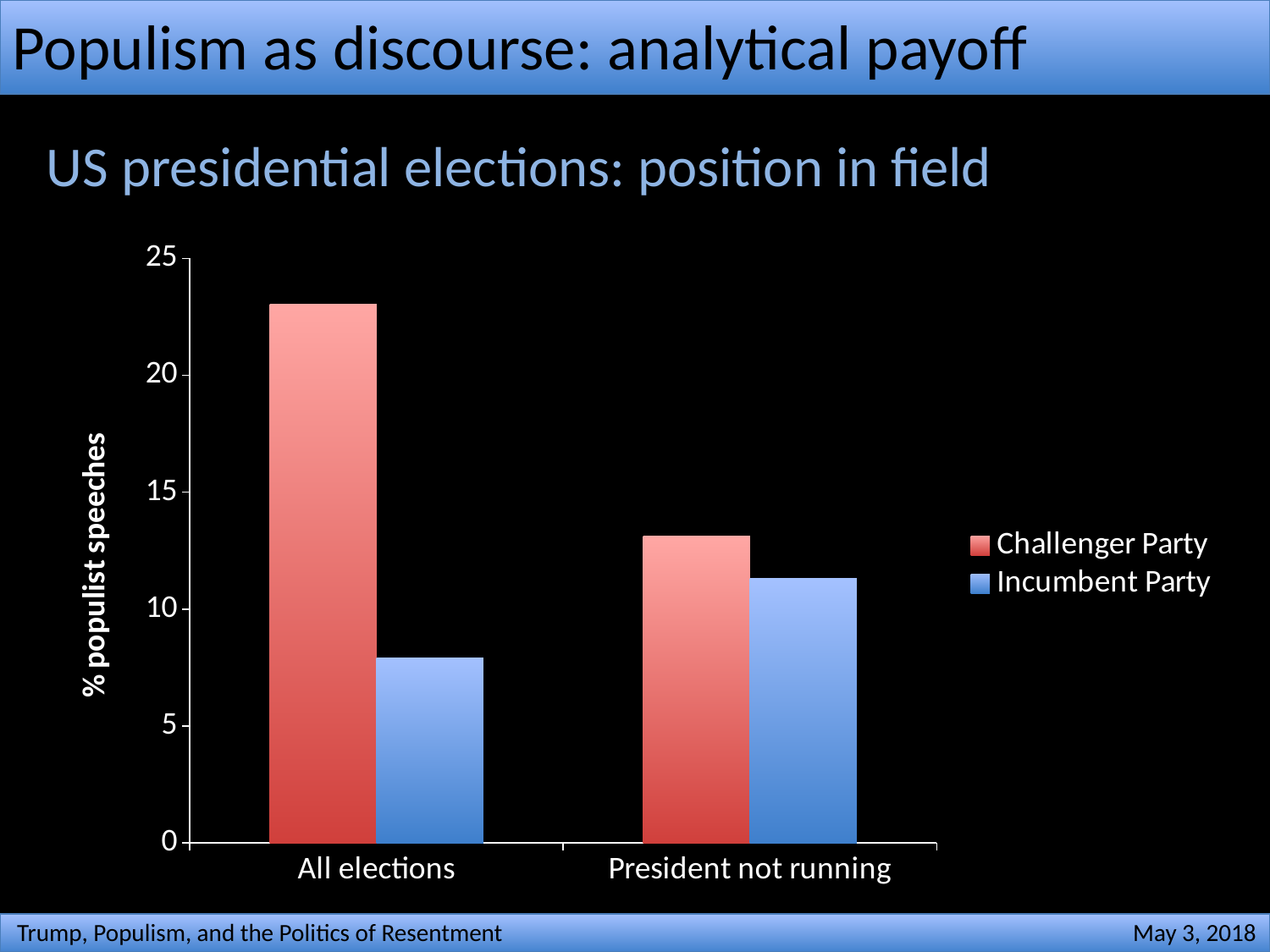
Is the value for Incumbent Party in All elections greater or less than 10? less Is the value for Incumbent Party in President not running greater or less than 15? less Is the value for Challenger Party in President not running greater or less than 15? less Which bar on the chart is the lowest? Incumbent Party in All elections How many series does the legend list? 2 For the Incumbent Party, which category has the larger value, All elections or President not running? President not running What is the label of the vertical axis? % populist speeches What is the title of the chart? US presidential elections: position in field What kind of chart is shown on the slide? bar chart How many categories are shown on the x axis? 2 In the All elections category, which series has the larger value, Challenger Party or Incumbent Party? Challenger Party